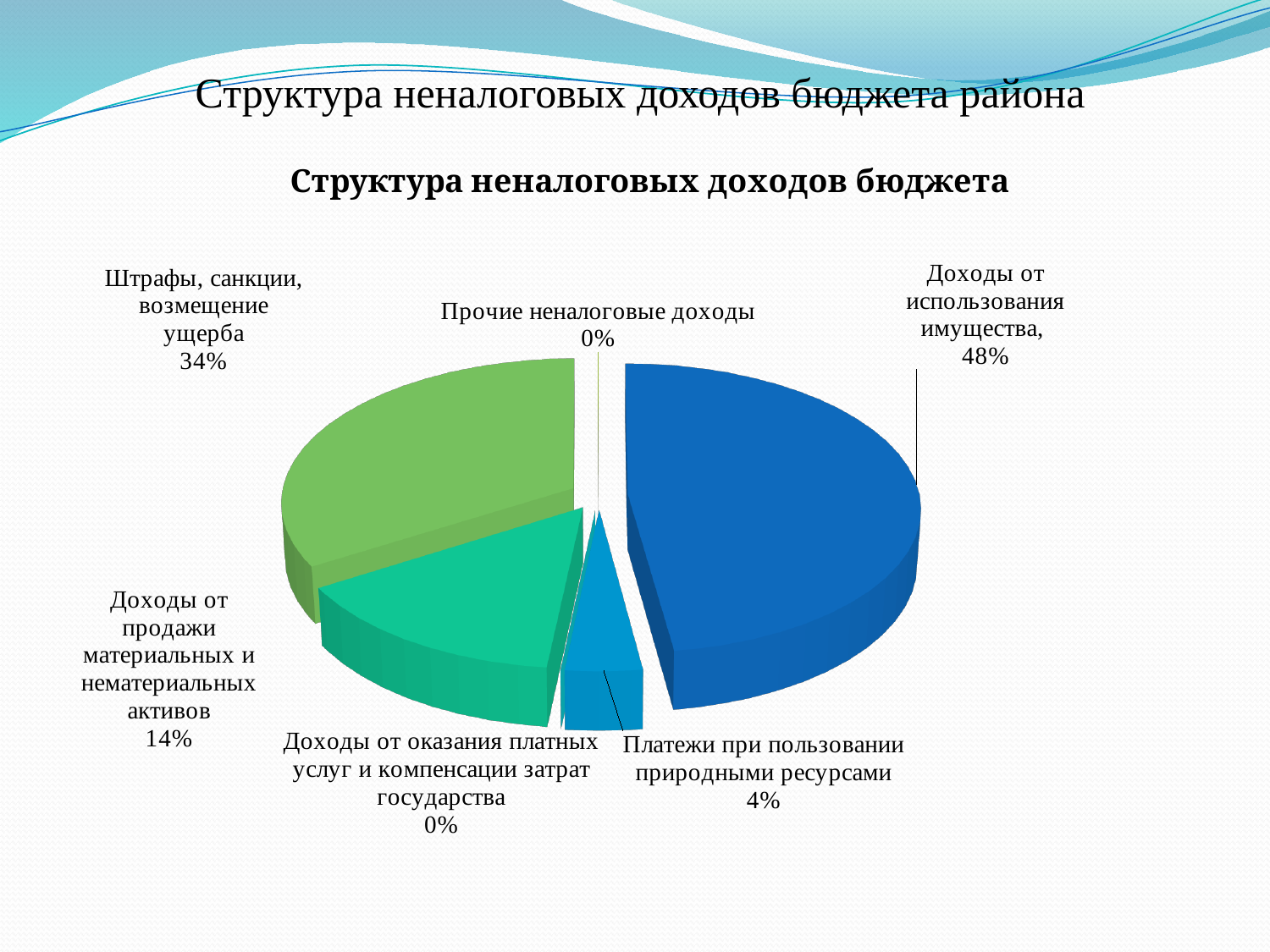
How many categories are shown in the pie chart? 6 What share of the pie is labelled for "Прочие неналоговые доходы"? 0% What is the combined share of "Штрафы, санкции, возмещение ущерба" and "Доходы от продажи материальных и нематериальных активов"? 48% What share of the pie is labelled for "Доходы от продажи материальных и нематериальных активов"? 14% What is the difference in percentage points between "Доходы от использования имущества" and "Штрафы, санкции, возмещение ущерба"? 14 percentage points What kind of chart is shown on the slide? Pie chart What share of the pie is labelled for "Доходы от использования имущества"? 48% What share of the pie is labelled for "Штрафы, санкции, возмещение ущерба"? 34% Which category has the largest share of the pie? Доходы от использования имущества Which is larger: the share for "Доходы от продажи материальных и нематериальных активов" or the share for "Платежи при пользовании природными ресурсами"? Доходы от продажи материальных и нематериальных активов What is the title of the chart? Структура неналоговых доходов бюджета What share of the pie is labelled for "Платежи при пользовании природными ресурсами"? 4%